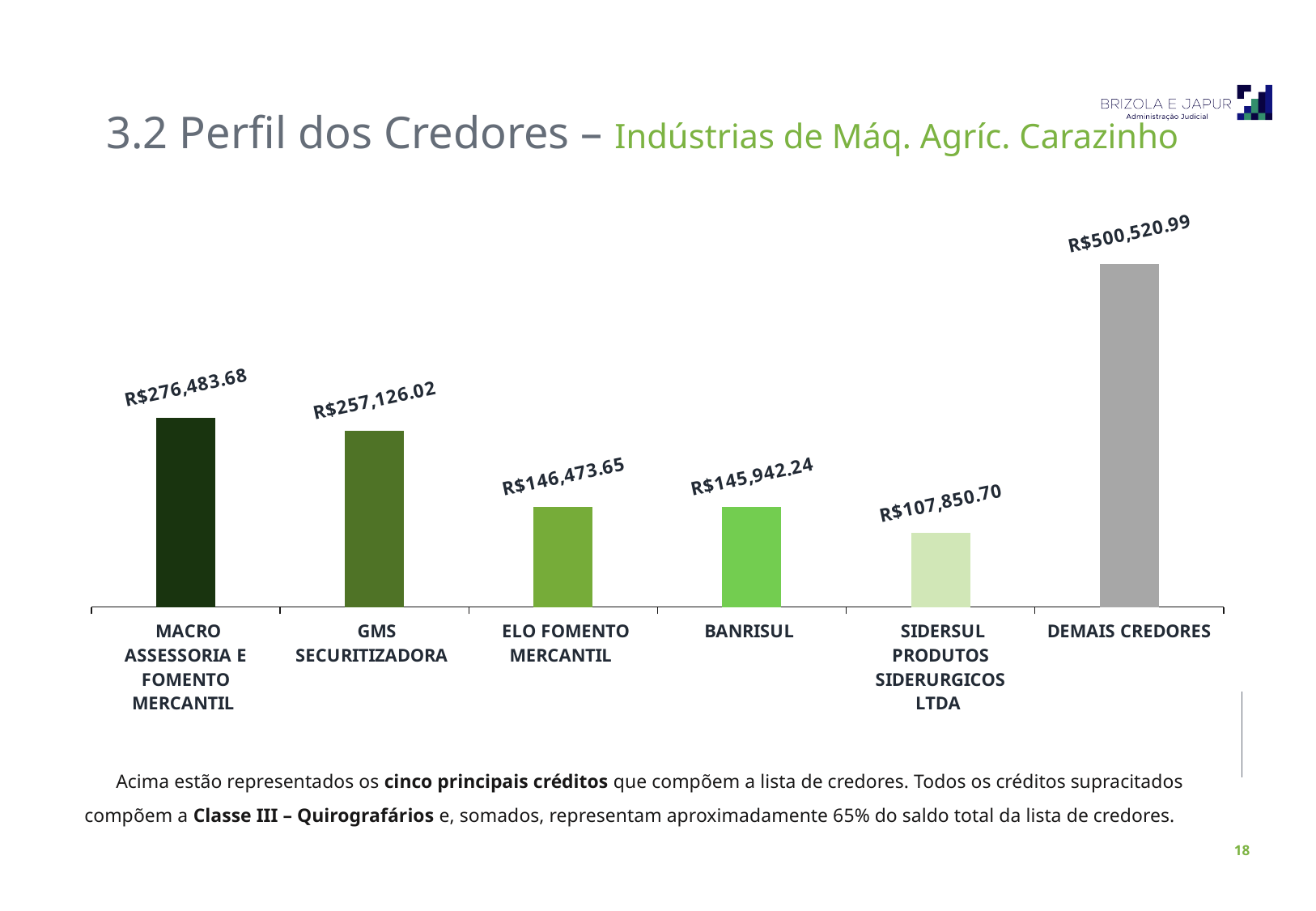
Which category has the lowest value? SIDERSUL PRODUTOS SIDERURGICOS LTDA What is the value for BANRISUL? R$145,942.24 What is the value for DEMAIS CREDORES? R$500,520.99 What kind of chart is shown on the slide? Bar chart What is the value for SIDERSUL PRODUTOS SIDERURGICOS LTDA? R$107,850.70 How many categories are shown in the chart? 6 What colour is the bar for DEMAIS CREDORES? Grey Which is larger, the value for MACRO ASSESSORIA E FOMENTO MERCANTIL or the value for GMS SECURITIZADORA? MACRO ASSESSORIA E FOMENTO MERCANTIL What is the value for GMS SECURITIZADORA? R$257,126.02 What is the difference between the values for MACRO ASSESSORIA E FOMENTO MERCANTIL and GMS SECURITIZADORA? R$19,357.66 Which category has the highest value? DEMAIS CREDORES What is the difference between the values for ELO FOMENTO MERCANTIL and BANRISUL? R$531.41